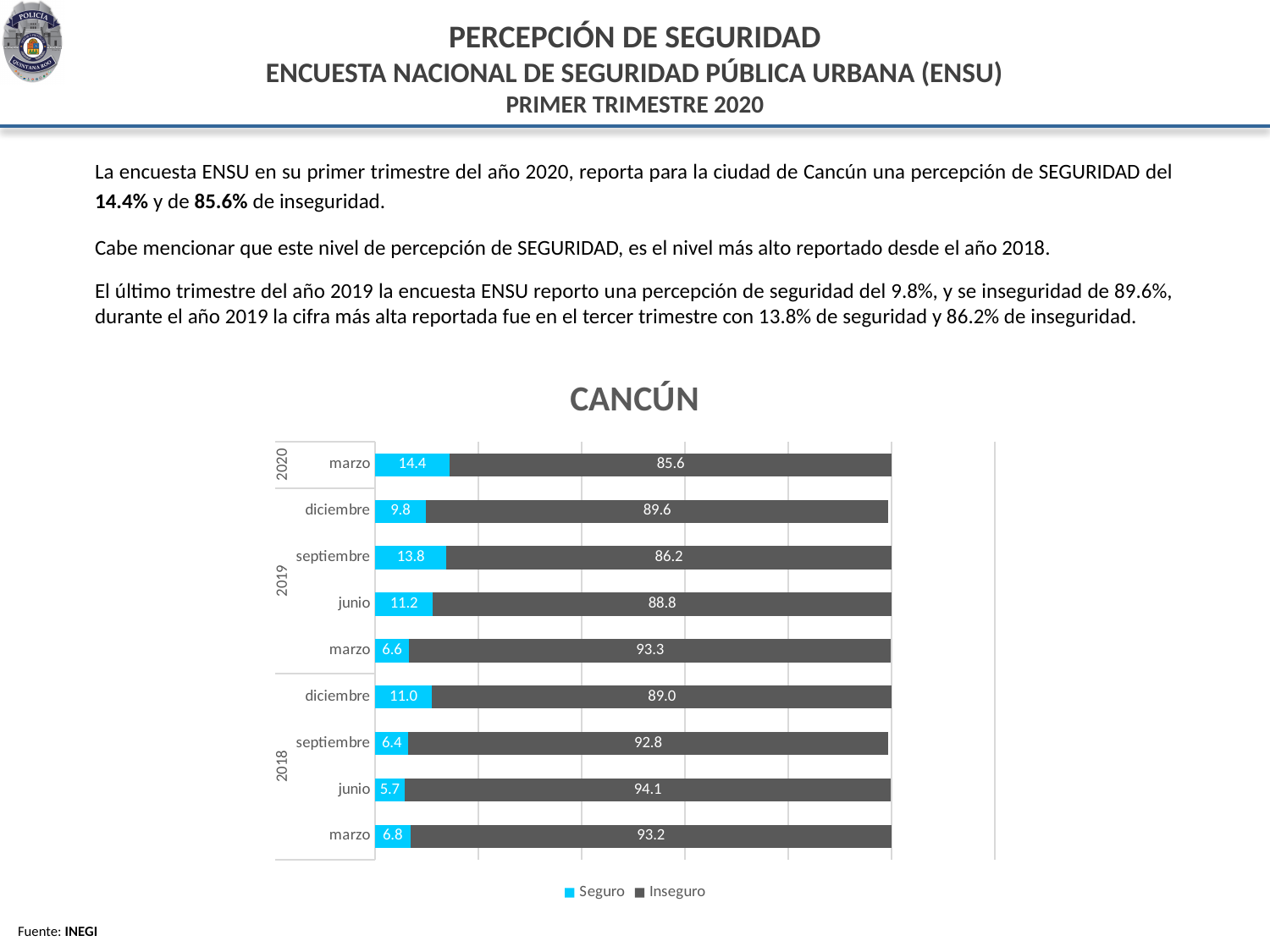
What is the difference between the Seguro values for marzo 2020 and diciembre 2019 in the CANCÚN chart? 4.6 What are the two legend entries in the CANCÚN chart? Seguro and Inseguro Which period has the highest Seguro value in the CANCÚN chart? marzo 2020 What kind of chart is the CANCÚN chart? Stacked bar chart What is the Inseguro value for junio 2018 in the CANCÚN chart? 94.1 What is the total of the stacked bar for marzo 2019 in the CANCÚN chart? 99.9 Which period has the lowest Seguro value in the CANCÚN chart? junio 2018 What is the Inseguro value for diciembre 2019 in the CANCÚN chart? 89.6 Which is larger in the CANCÚN chart: the Seguro value for septiembre 2019 or for junio 2019? septiembre 2019 How many periods (bars) are shown in the CANCÚN chart? 9 How many series does the legend of the CANCÚN chart list? 2 What is the Seguro value for marzo 2020 in the CANCÚN chart? 14.4